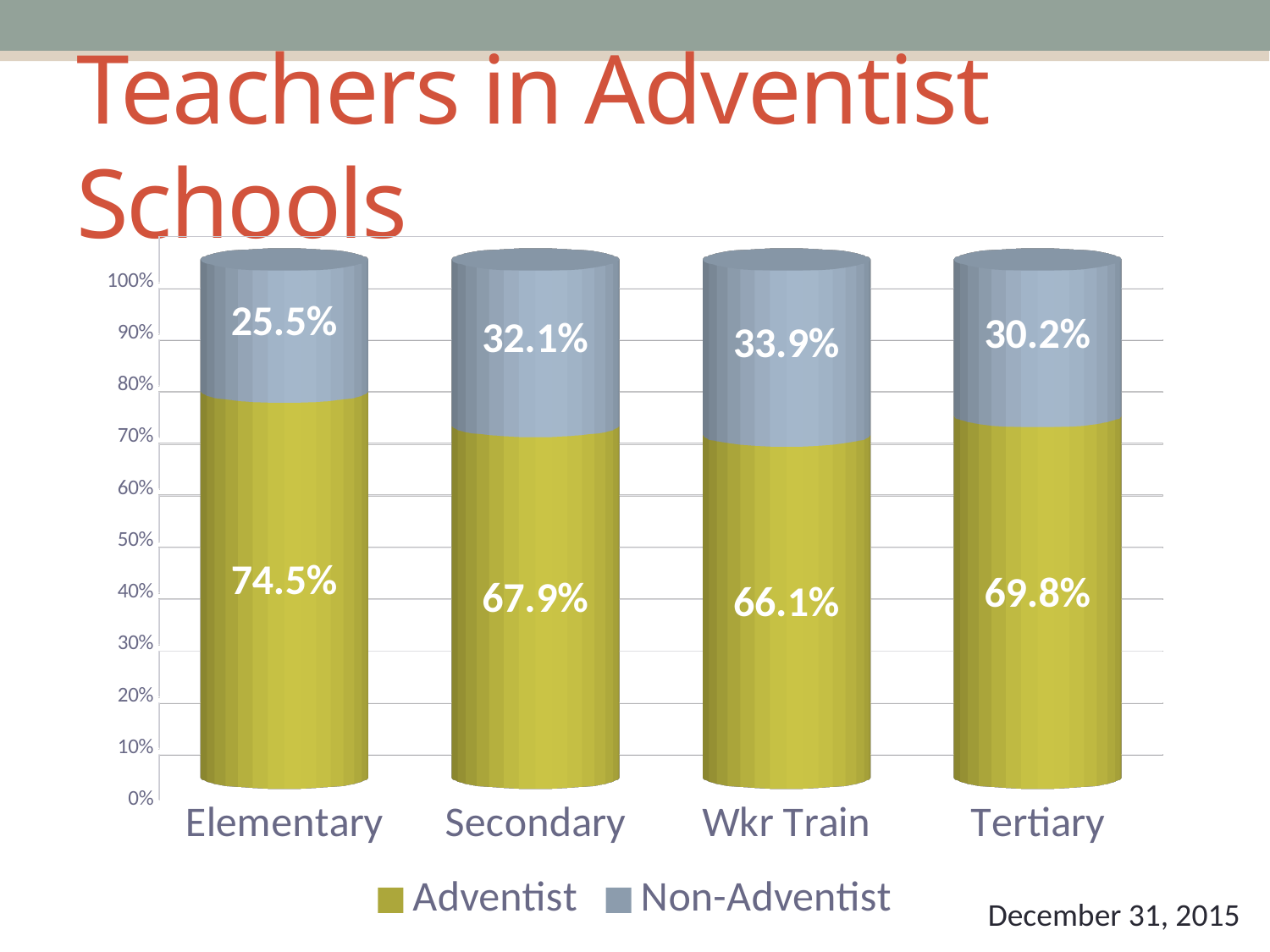
How many categories are shown on the x axis? 4 What kind of chart is shown on the slide? Stacked bar chart Which category has the highest Non-Adventist percentage? Wkr Train What is the difference between the Adventist percentages for Elementary and Secondary? 6.6% How many series does the legend list? 2 What is the Adventist percentage for Tertiary? 69.8% Which is larger, the Non-Adventist percentage for Tertiary or for Elementary? Tertiary What is the Non-Adventist percentage for Secondary? 32.1% What is the Adventist percentage for Elementary? 74.5% What is the Non-Adventist percentage for Wkr Train? 33.9% Which category has the highest Adventist percentage? Elementary Which category has the lowest Adventist percentage? Wkr Train